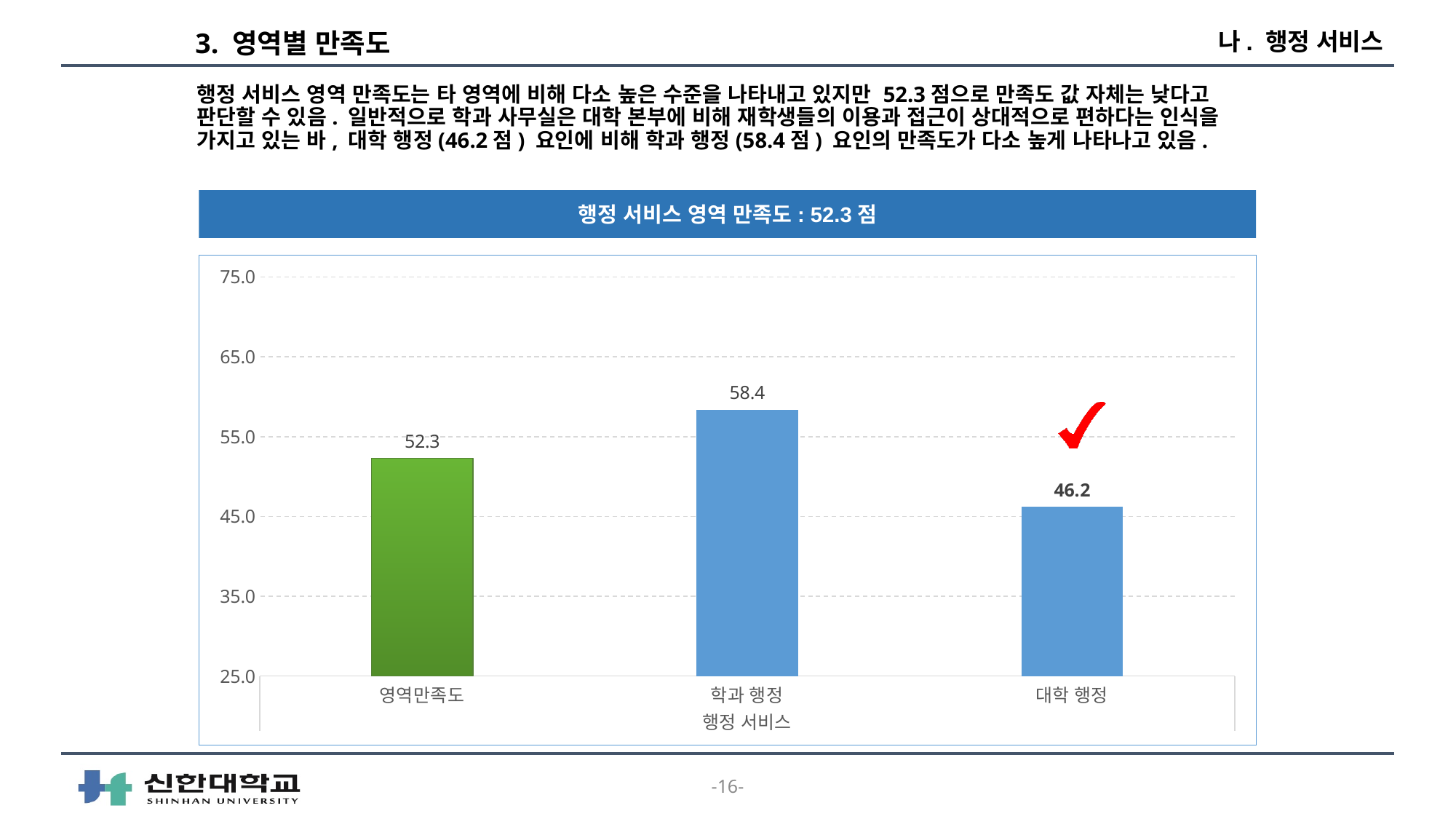
What is the value for 학과 행정? 58.4 What is the value for 영역만족도? 52.3 What is the value for 대학 행정? 46.2 Is the value for 학과 행정 greater or less than 55.0? greater What is the title shown in the blue banner above the chart? 행정 서비스 영역 만족도 : 52.3 점 Which category has the highest value? 학과 행정 What is the difference between the values for 학과 행정 and 영역만족도? 6.1 What kind of chart is shown on the slide? bar chart Which category has the lowest value? 대학 행정 Which is larger, the value for 영역만족도 or the value for 대학 행정? 영역만족도 What is the difference between the values for 학과 행정 and 대학 행정? 12.2 How many bars are shown in the chart? 3